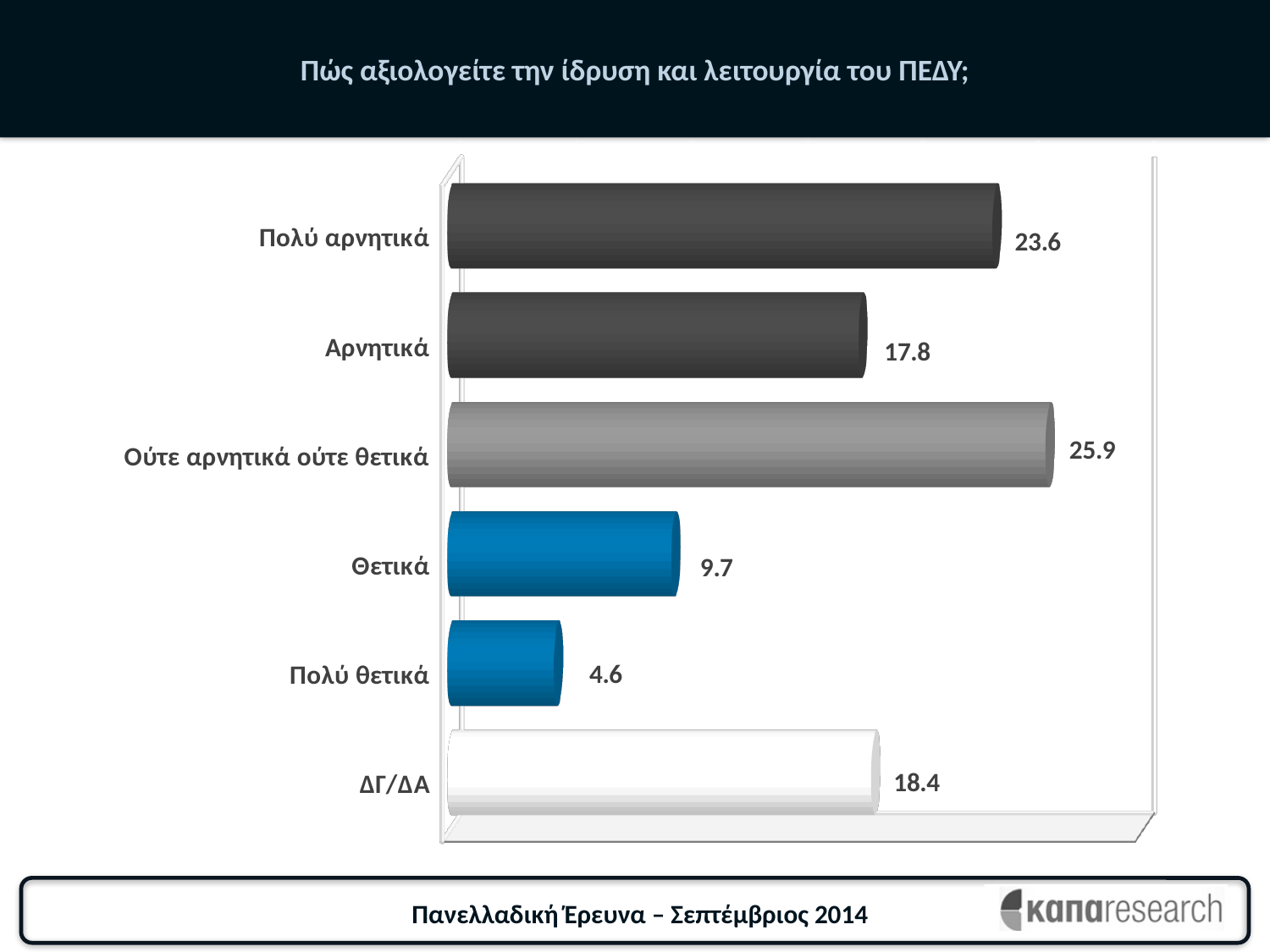
Which is larger, the value for Θετικά or the value for ΔΓ/ΔΑ? ΔΓ/ΔΑ What is the value for Πολύ θετικά? 4.6 How many categories are shown in the chart? 6 What is the value for Πολύ αρνητικά? 23.6 What is the value for ΔΓ/ΔΑ? 18.4 Which category has the lowest value? Πολύ θετικά What is the difference between the values for Πολύ αρνητικά and Αρνητικά? 5.8 What is the value for Ούτε αρνητικά ούτε θετικά? 25.9 What is the value for Αρνητικά? 17.8 What is the value for Θετικά? 9.7 What kind of chart is shown on the slide? Bar chart Which category has the highest value? Ούτε αρνητικά ούτε θετικά